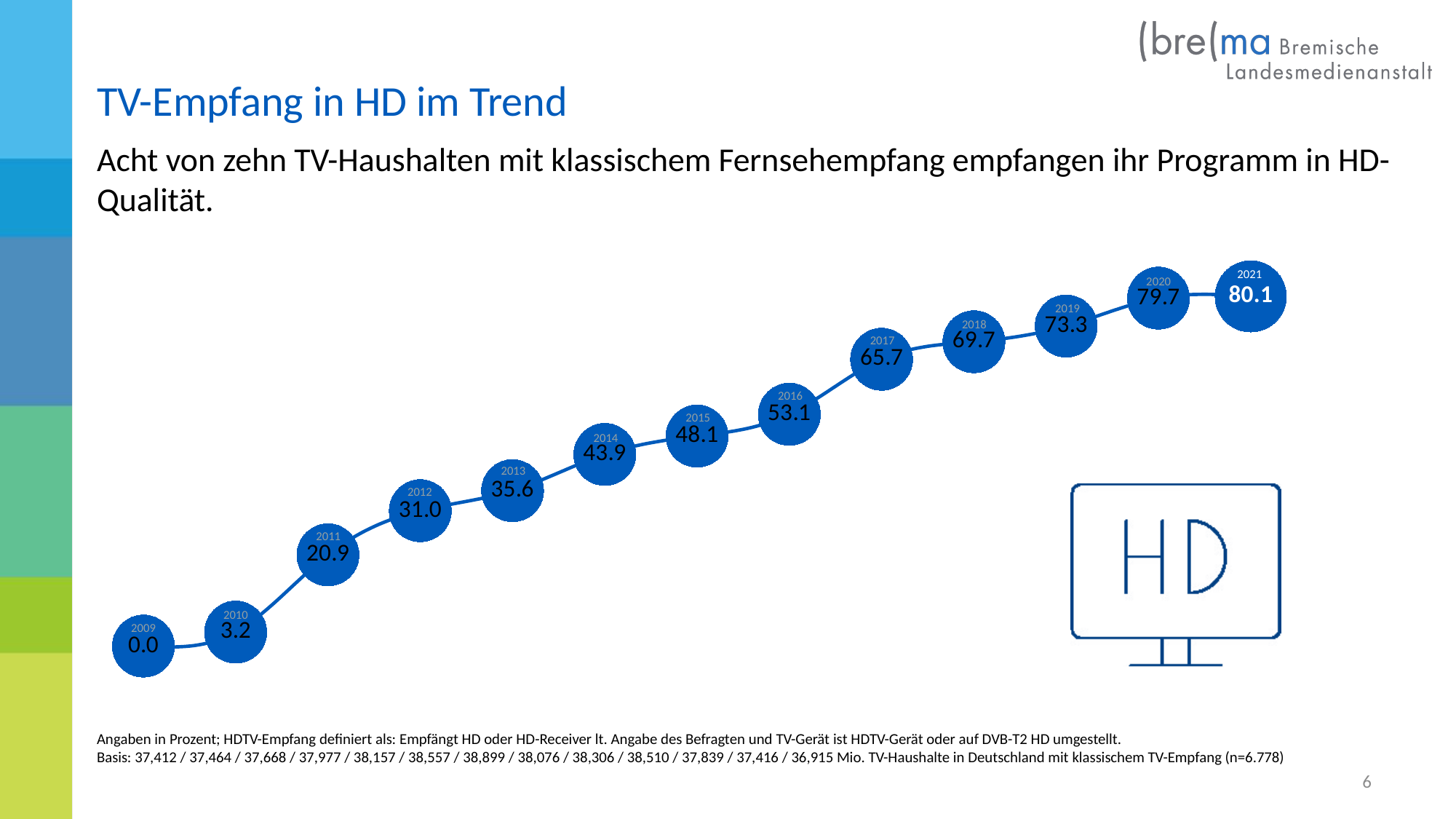
What is the title of the slide containing the chart? TV-Empfang in HD im Trend Do the values rise or fall from 2009 to 2021? rise What is the value for 2021? 80.1 What is the value for 2011? 20.9 What is the difference between the values for 2021 and 2020? 0.4 How many years are plotted on the chart? 13 Which year has the highest value? 2021 What is the difference between the values for 2016 and 2015? 5.0 What is the value for 2015? 48.1 What kind of chart is shown? line chart Which is larger, the value for 2013 or the value for 2014? 2014 Which year has the lowest value? 2009